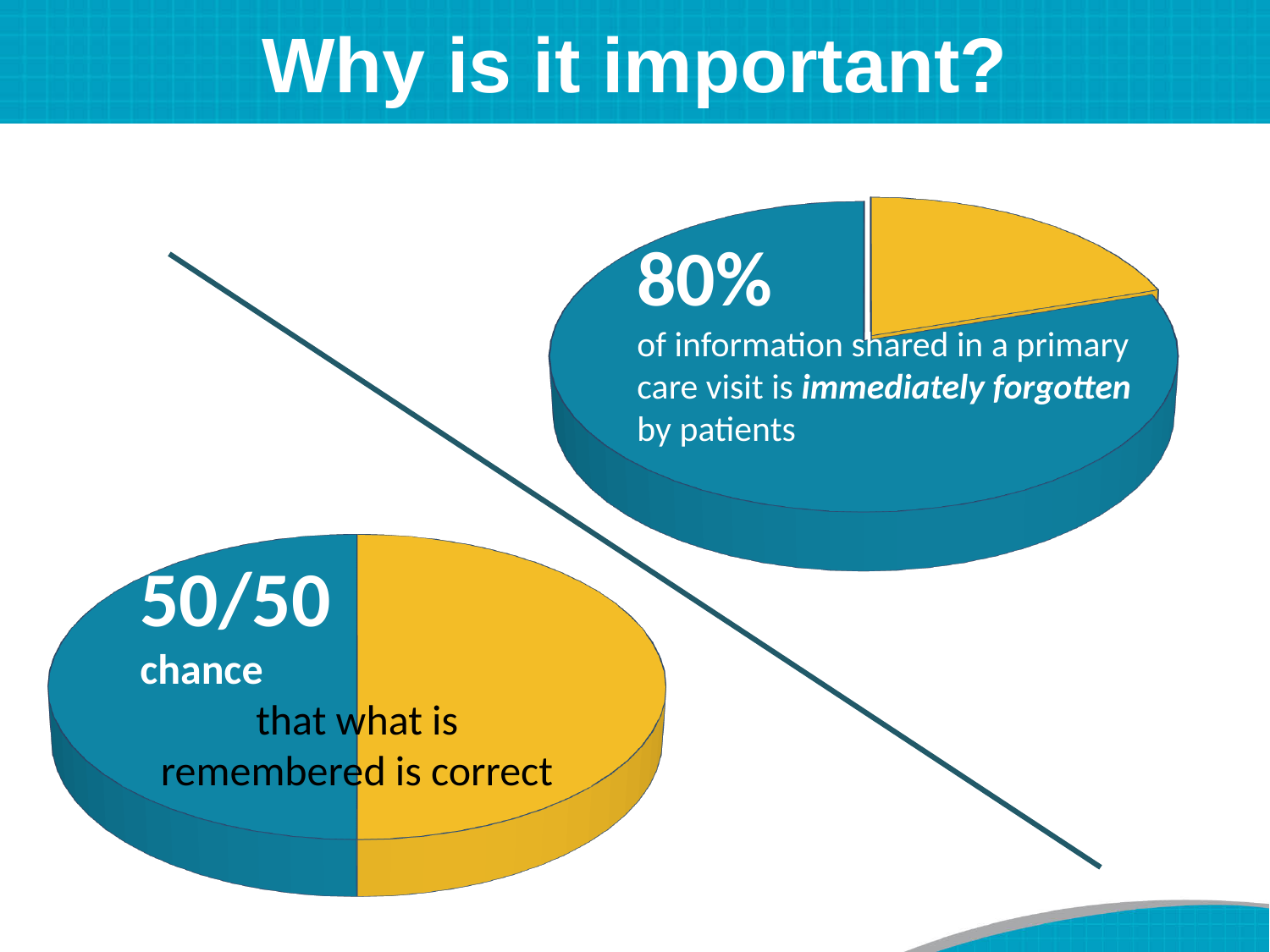
What two colours are used for the slices in the pie charts? Blue and yellow In the top-right pie chart, is the yellow slice's share greater or less than 50%? less In the top-right pie chart, what share of information shared in a primary care visit is immediately forgotten by patients? 80% What is the title of the slide containing the two pie charts? Why is it important? In the bottom-left pie chart, what chance is shown that what is remembered is correct? 50/50 How many charts are on the slide? 2 In the top-right pie chart, how many slices are there? 2 What kind of chart is shown in the bottom-left of the slide? Pie chart In the top-right pie chart, is the blue slice's share greater or less than 50%? greater In the top-right pie chart, which slice is larger, the blue one or the yellow one? The blue one In the bottom-left pie chart, how many slices are there? 2 What kind of chart is shown in the top-right of the slide? Pie chart